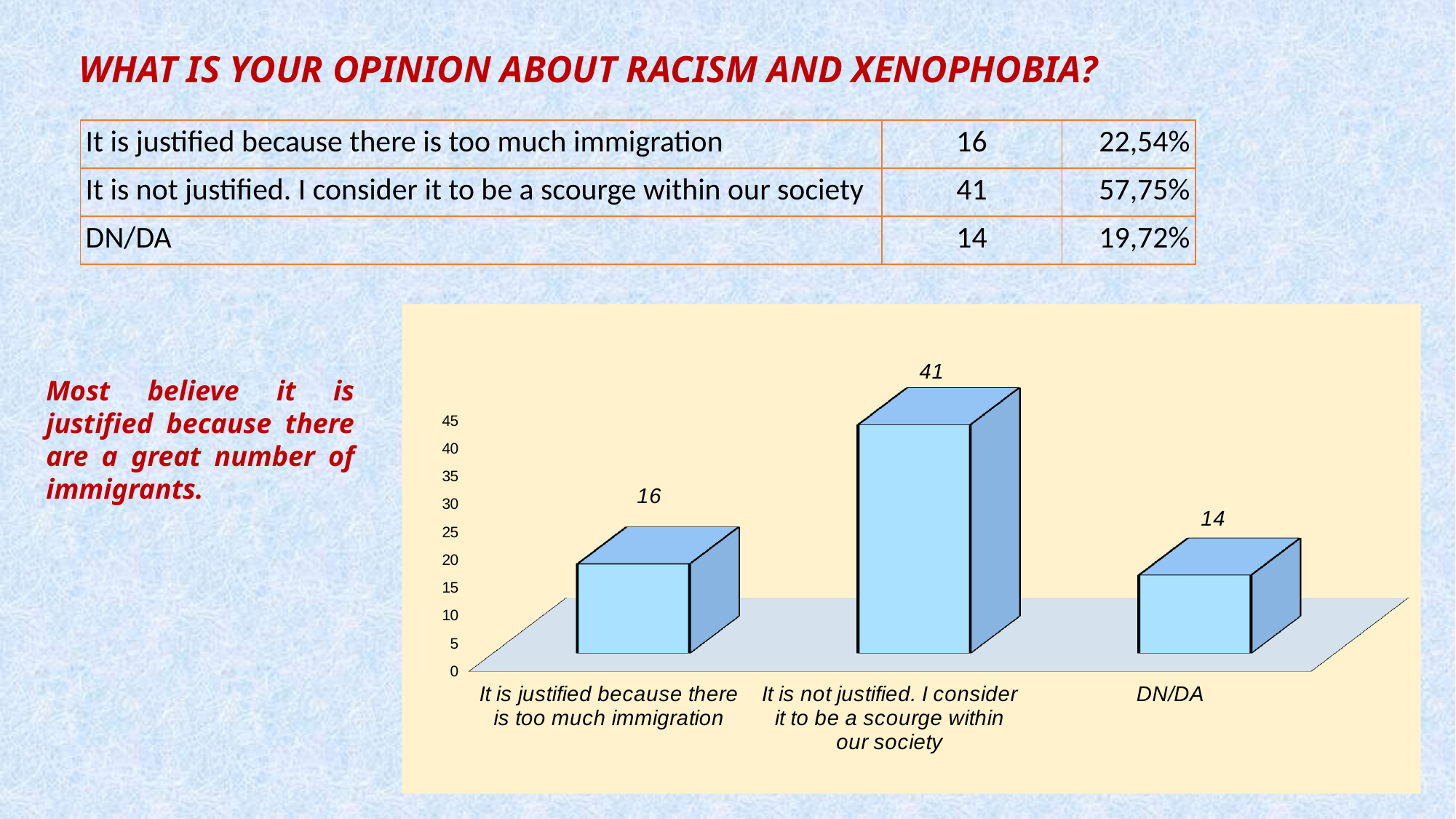
What is the value for DN/DA? 14 Which category has the highest value? It is not justified. I consider it to be a scourge within our society Which is larger: the value for "It is justified because there is too much immigration" or the value for DN/DA? It is justified because there is too much immigration How many categories are shown in the chart? 3 What is the value for "It is justified because there is too much immigration"? 16 What is the value for "It is not justified. I consider it to be a scourge within our society"? 41 What is the difference between the value for "It is not justified. I consider it to be a scourge within our society" and the value for DN/DA? 27 What is the highest value shown on the vertical axis of the chart? 45 What kind of chart is shown on the slide? bar chart Which category has the lowest value? DN/DA Is the value for "It is not justified. I consider it to be a scourge within our society" greater or less than 35? greater What is the difference between the value for "It is justified because there is too much immigration" and the value for DN/DA? 2